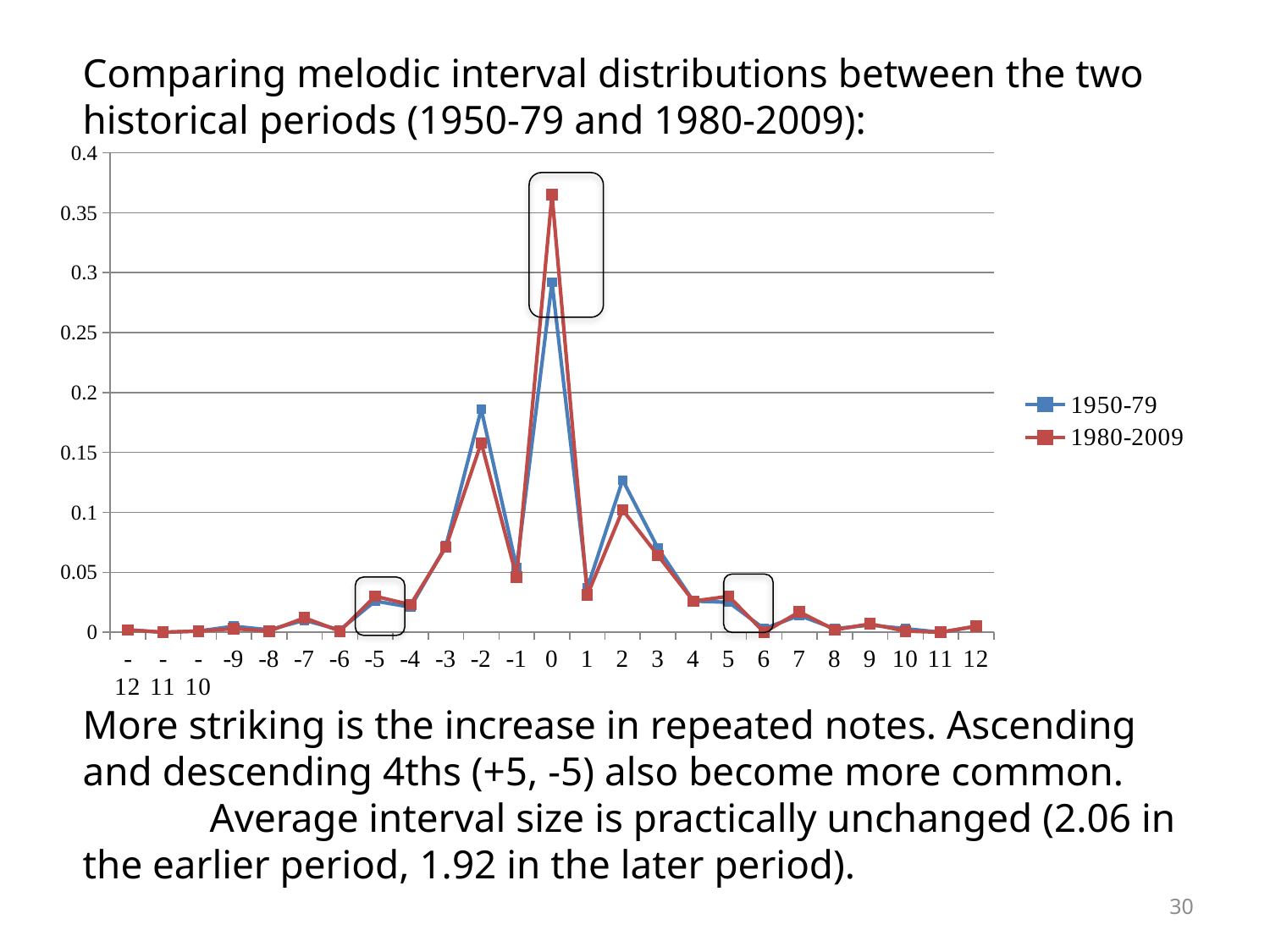
At which interval does the 1950-79 series reach its highest value? 0 How many series does the legend list? 2 At interval 0, which series has the higher value, 1950-79 or 1980-2009? 1980-2009 What are the two series named in the legend? 1950-79 and 1980-2009 Is the value for the 1950-79 series at interval -2 greater or less than 0.15? greater What kind of chart is shown on the slide? line chart At interval -2, which series has the higher value, 1950-79 or 1980-2009? 1950-79 How many interval categories are plotted along the x axis? 25 Is the value for the 1950-79 series at interval 0 greater or less than 0.25? greater At which interval does the 1980-2009 series reach its highest value? 0 Is the value for the 1950-79 series at interval 2 greater or less than 0.1? greater